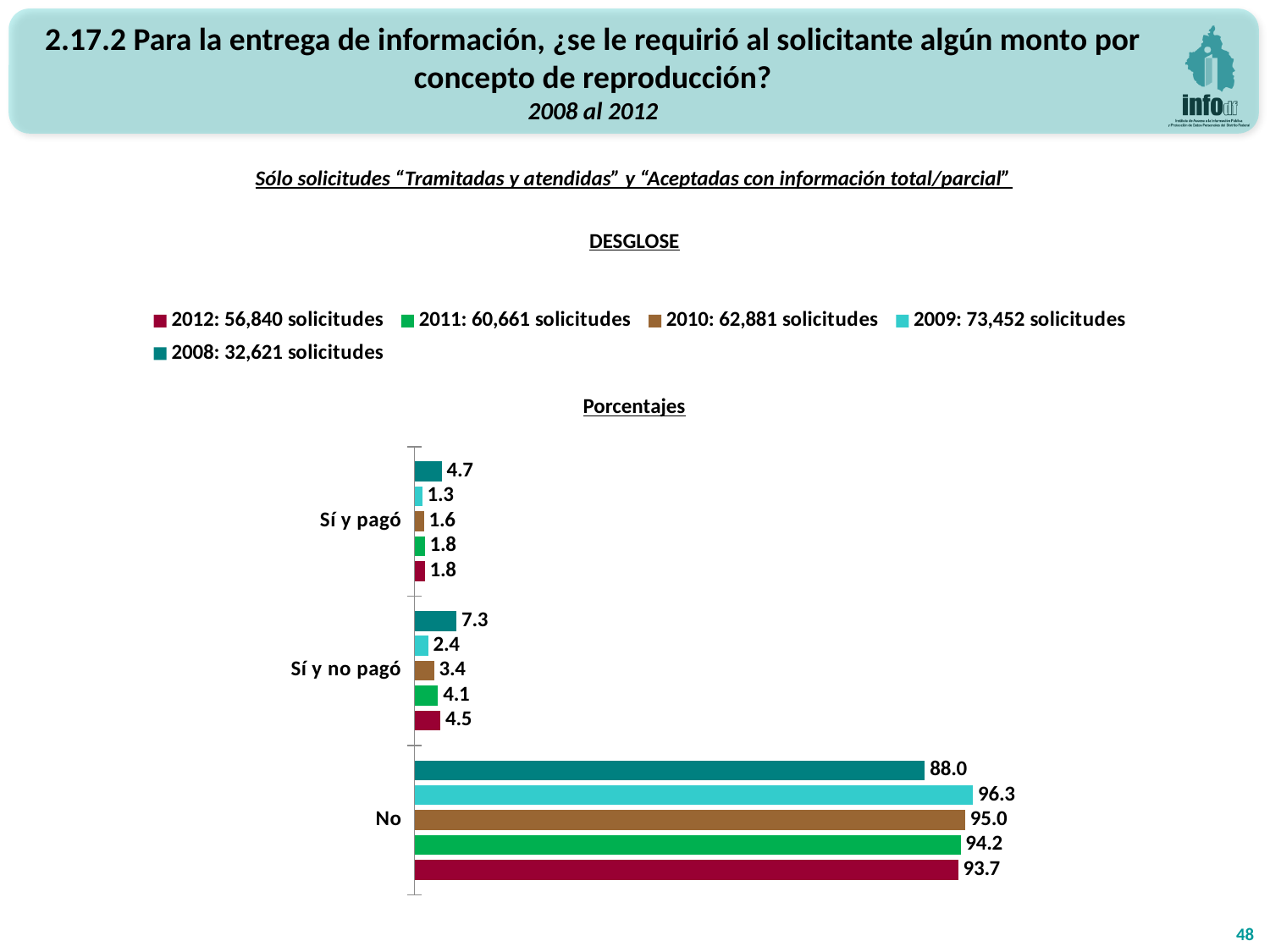
What kind of chart is shown on the slide? bar chart According to the legend, how many solicitudes were there in 2010? 62,881 What is the percentage for 'Sí y no pagó' in 2012? 4.5 What is the difference between the 'Sí y no pagó' percentages for 2008 and 2009? 4.9 What is the percentage for 'Sí y pagó' in 2008? 4.7 Which is larger for 'Sí y no pagó': the 2010 value or the 2011 value? 2011 Which year has the highest percentage for 'No'? 2009 What is the percentage for 'No' in 2009? 96.3 How many series does the legend list? 5 What is the difference between the 'No' percentages for 2009 and 2008? 8.3 How many categories are shown on the chart? 3 Which year has the lowest percentage for 'Sí y pagó'? 2009